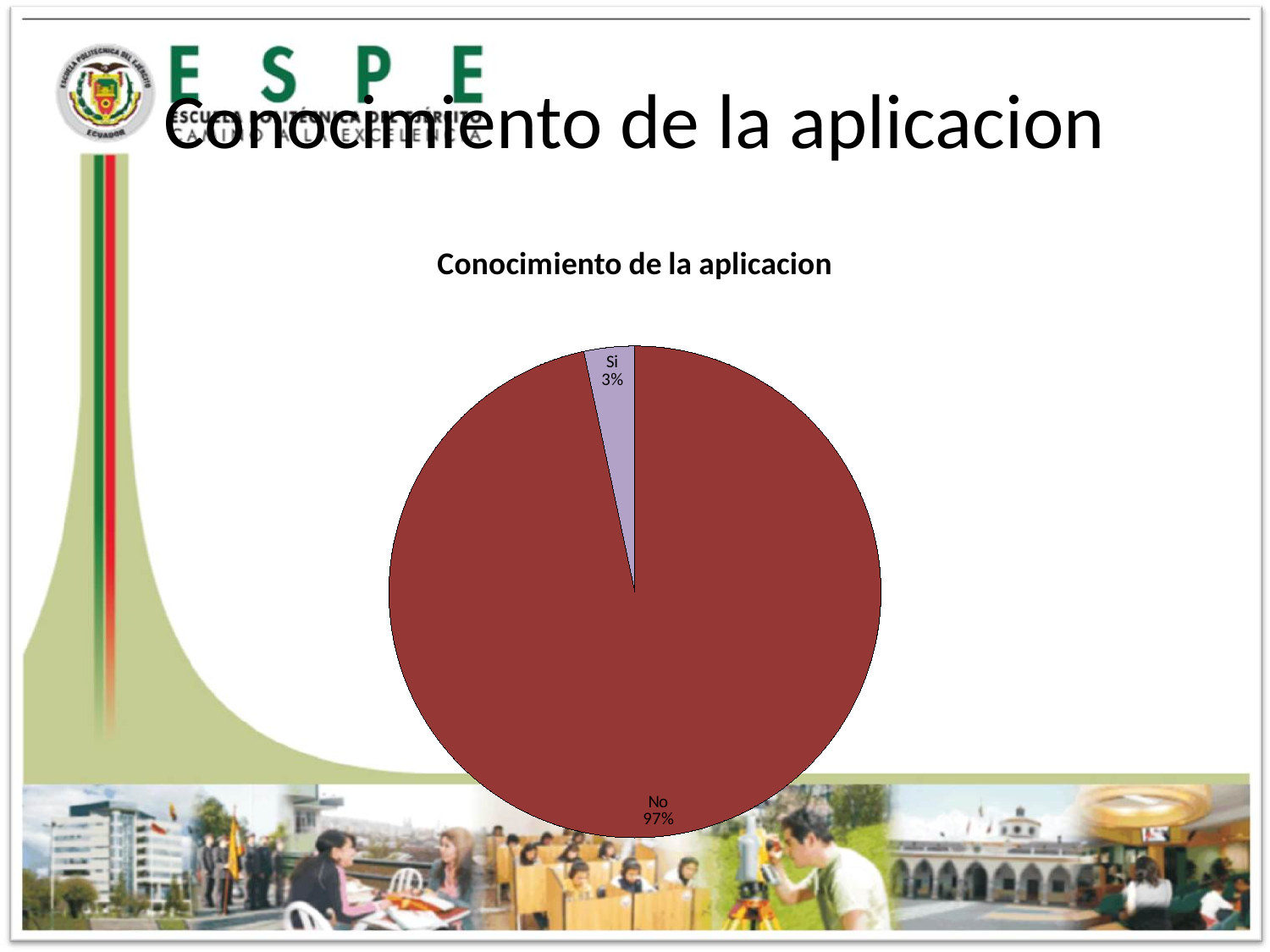
What is the difference in percentage points between the "No" and "Si" slices? 94 What percentage of the pie does the "Si" slice represent? 3% What kind of chart is shown on the slide? pie chart What is the chart's title? Conocimiento de la aplicacion Which is larger, the "Si" slice or the "No" slice? No Which slice is the largest in the pie chart? No What colour is the "No" slice of the pie chart? dark red Which slice is the smallest in the pie chart? Si How many slices does the pie chart have? 2 What percentage of the pie does the "No" slice represent? 97%